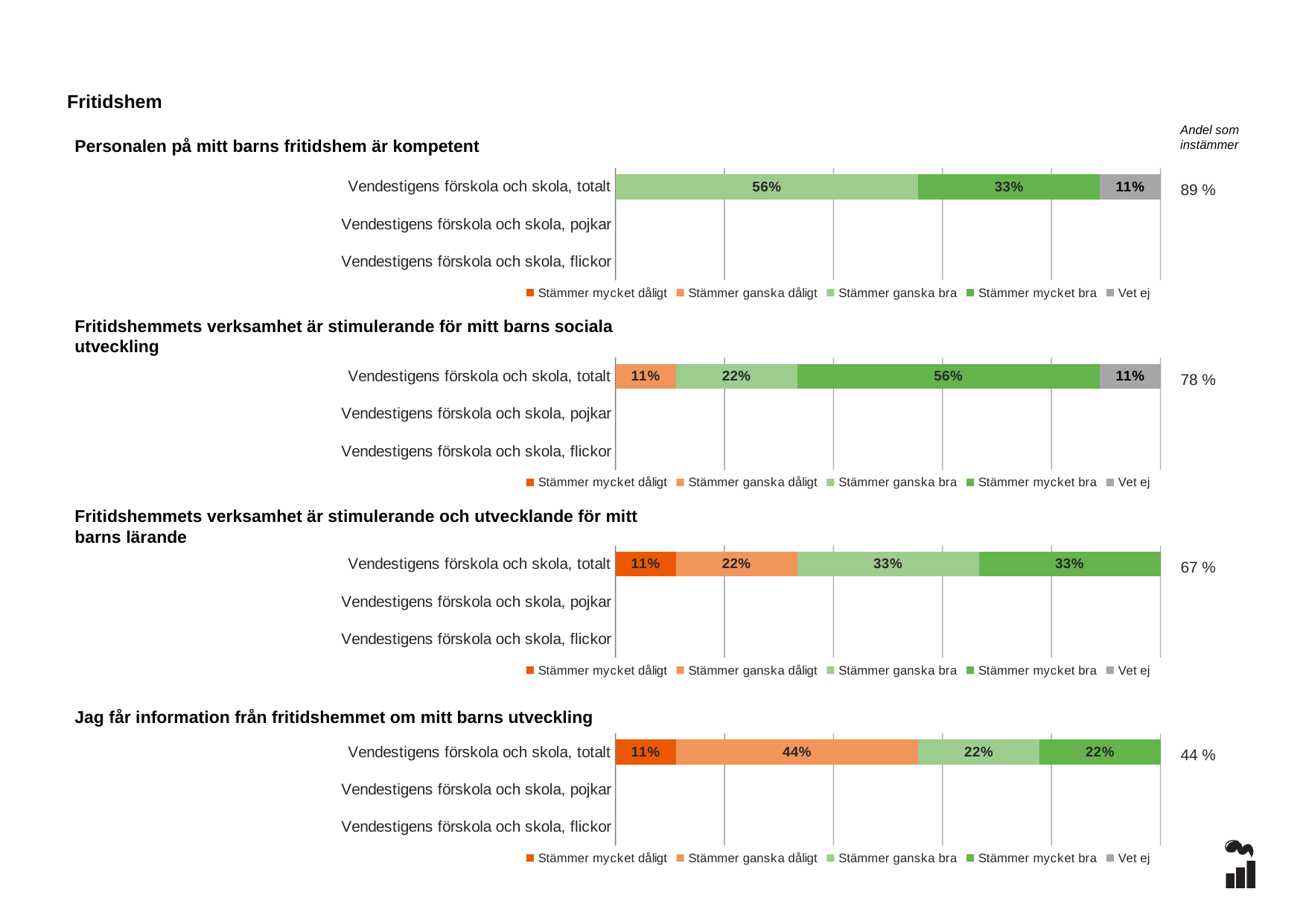
In the chart 'Jag får information från fritidshemmet om mitt barns utveckling', what is the value of 'Stämmer ganska dåligt' for 'Vendestigens förskola och skola, totalt'? 44% In the chart 'Personalen på mitt barns fritidshem är kompetent', what is the value of 'Vet ej' for 'Vendestigens förskola och skola, totalt'? 11% How many series does the legend list in the chart 'Jag får information från fritidshemmet om mitt barns utveckling'? 5 What is the 'Andel som instämmer' value shown for the chart 'Jag får information från fritidshemmet om mitt barns utveckling'? 44 % In the chart 'Personalen på mitt barns fritidshem är kompetent', which is larger for 'Vendestigens förskola och skola, totalt': 'Stämmer ganska bra' or 'Stämmer mycket bra'? Stämmer ganska bra What kind of chart is 'Personalen på mitt barns fritidshem är kompetent'? Stacked bar chart In the chart 'Fritidshemmets verksamhet är stimulerande för mitt barns sociala utveckling', what is the value of 'Stämmer ganska dåligt' for 'Vendestigens förskola och skola, totalt'? 11% In the chart 'Fritidshemmets verksamhet är stimulerande och utvecklande för mitt barns lärande', what is the value of 'Stämmer mycket dåligt' for 'Vendestigens förskola och skola, totalt'? 11% In the chart 'Jag får information från fritidshemmet om mitt barns utveckling', which segment of the 'Vendestigens förskola och skola, totalt' bar is the largest? Stämmer ganska dåligt In the chart 'Fritidshemmets verksamhet är stimulerande för mitt barns sociala utveckling', what is the value of 'Stämmer mycket bra' for 'Vendestigens förskola och skola, totalt'? 56% In the chart 'Personalen på mitt barns fritidshem är kompetent', what is the value of 'Stämmer ganska bra' for 'Vendestigens förskola och skola, totalt'? 56% In the chart 'Fritidshemmets verksamhet är stimulerande för mitt barns sociala utveckling', what is the difference between 'Stämmer mycket bra' and 'Stämmer ganska bra' for 'Vendestigens förskola och skola, totalt'? 34%